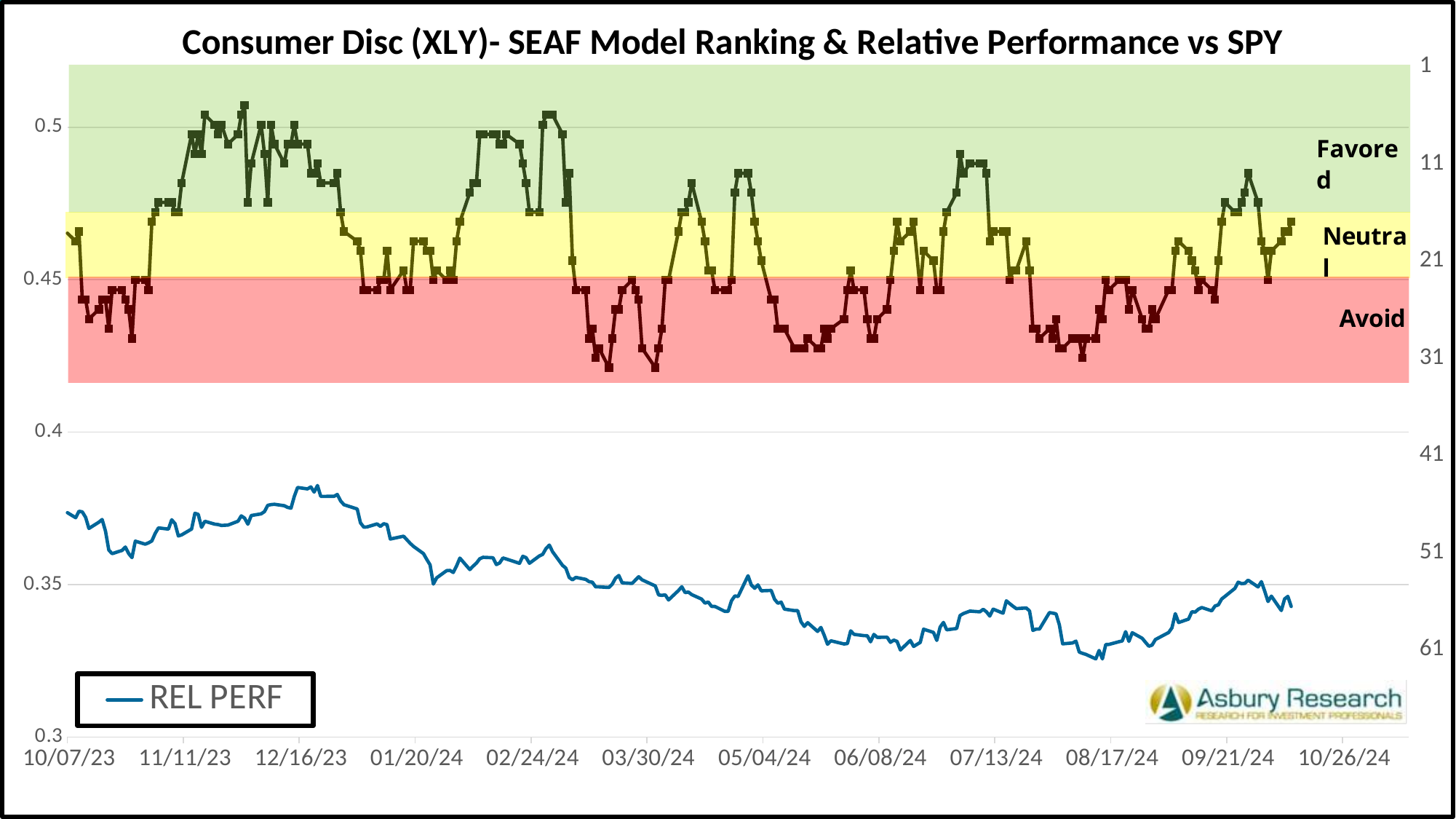
Does the REL PERF line rise or fall between 08/17/24 and 09/21/24? rise Which is larger, the REL PERF value at 10/07/23 or at 06/08/24? 10/07/23 Does the REL PERF line rise or fall between 12/16/23 and 06/08/24? fall Is the REL PERF value at 10/07/23 greater or less than 0.35? greater Which series is named in the legend? REL PERF What is the title of the chart? Consumer Disc (XLY)- SEAF Model Ranking & Relative Performance vs SPY Is the REL PERF value at 08/17/24 greater or less than 0.35? less Is the REL PERF value at 06/08/24 greater or less than 0.35? less How many date labels are shown on the x axis? 12 How many series does the legend list? 1 What kind of chart is shown on the slide? Line chart